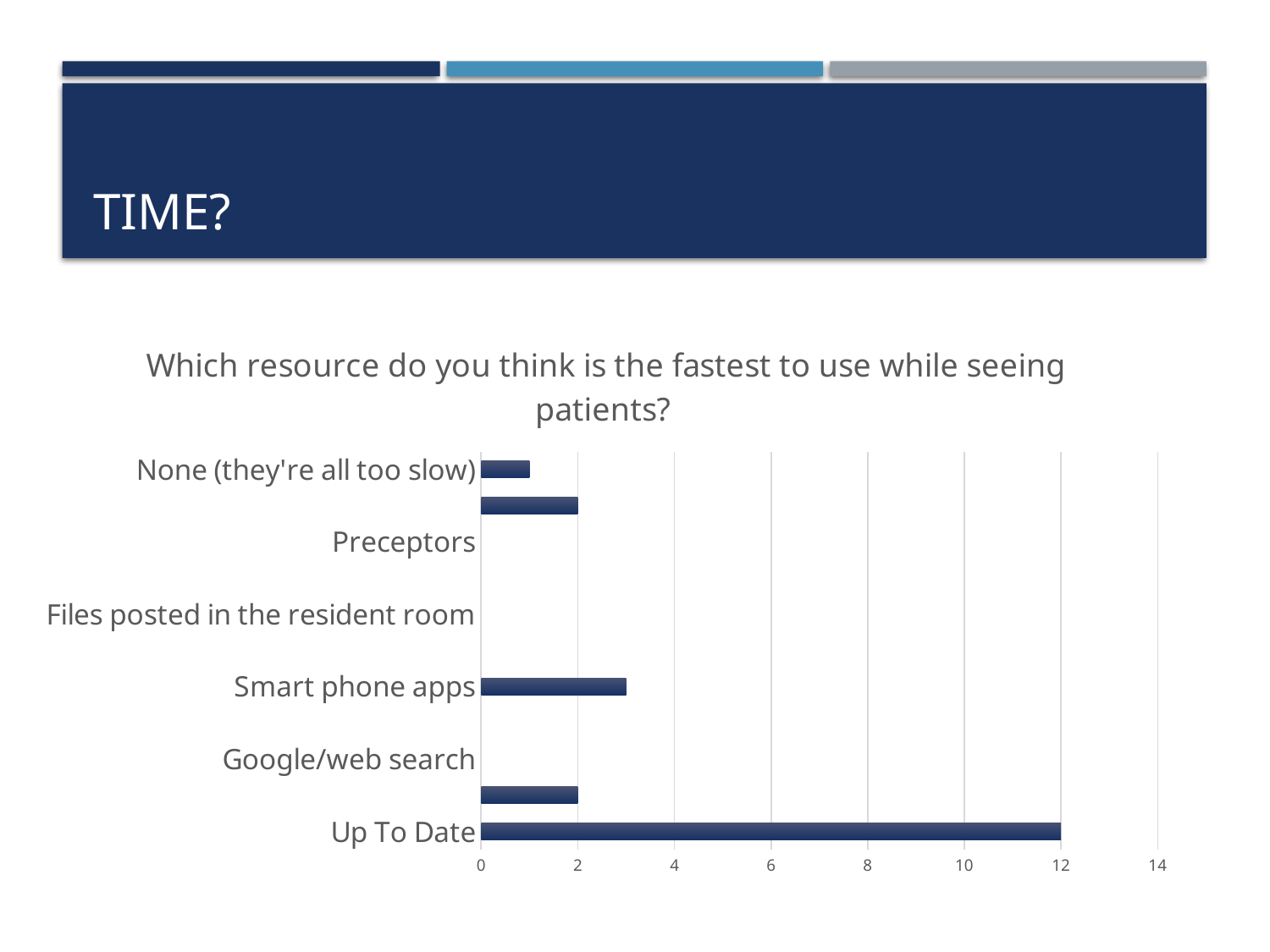
What is the value for Up To Date? 12 What is the title of the chart? Which resource do you think is the fastest to use while seeing patients? Which resource has the highest value in the chart? Up To Date Is the value for Up To Date greater or less than 10? greater Which is larger, the value for Smart phone apps or the value for None (they're all too slow)? Smart phone apps Is the value for None (they're all too slow) greater or less than 2? less How many category labels are shown on the vertical axis of the chart? 6 Is the value for Smart phone apps greater or less than 4? less What type of chart is shown on the slide? bar chart What is the highest value shown on the horizontal axis of the chart? 14 Which is larger, the value for Up To Date or the value for Smart phone apps? Up To Date